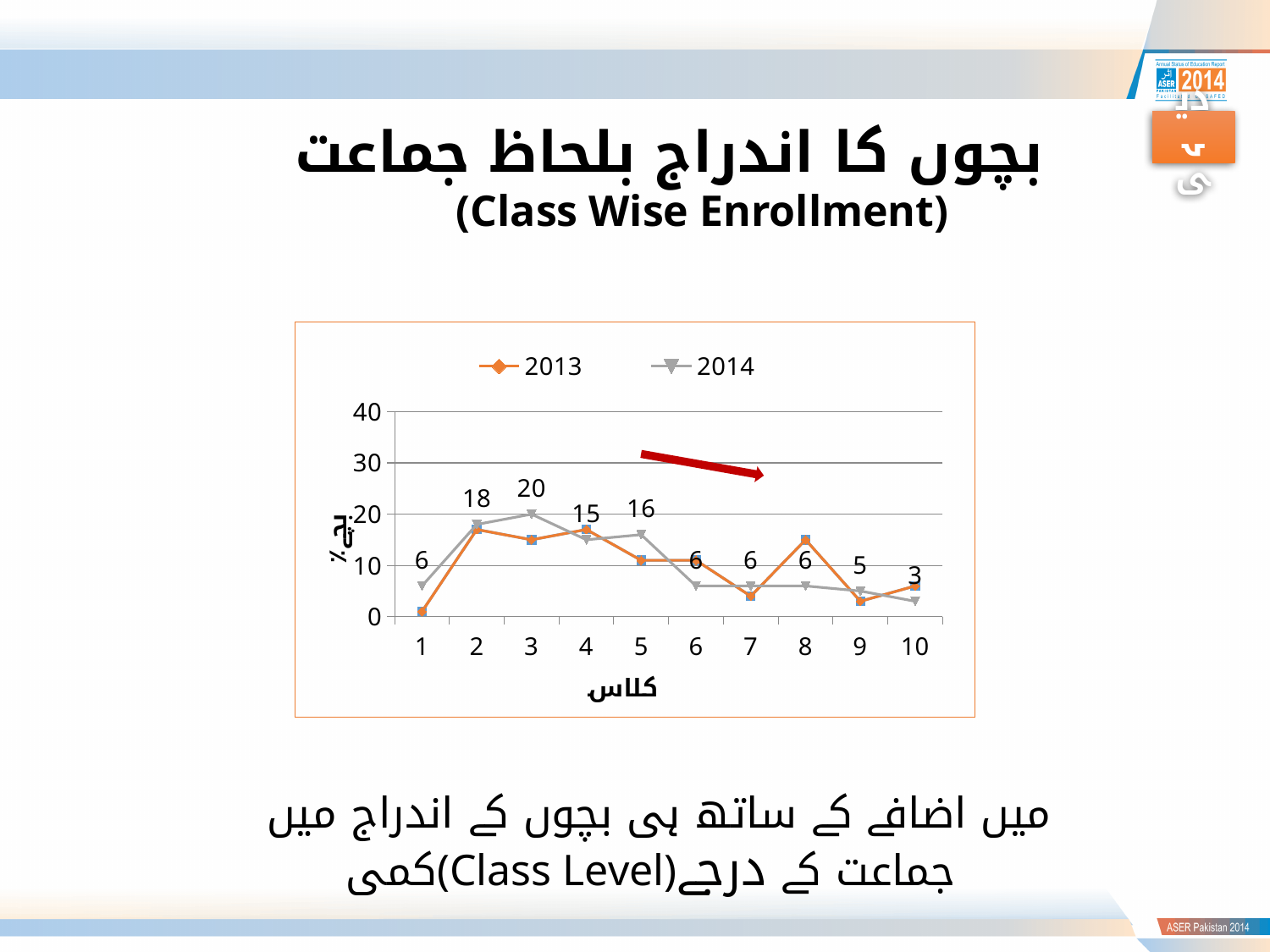
What is the 2014 value for class 10? 3 What is the 2014 value for class 2? 18 What is the 2014 value for class 3? 20 How many series does the legend list? 2 Is the 2013 value for class 8 greater or less than 10? greater What is the difference between the 2014 values for class 3 and class 10? 17 For 2014, which class has the larger value, class 2 or class 5? 2 Which class has the highest 2014 value? 3 What kind of chart is shown on the slide? line chart How many classes are shown on the x axis? 10 Is the 2013 value for class 1 greater or less than 10? less Which class has the lowest 2014 value? 10